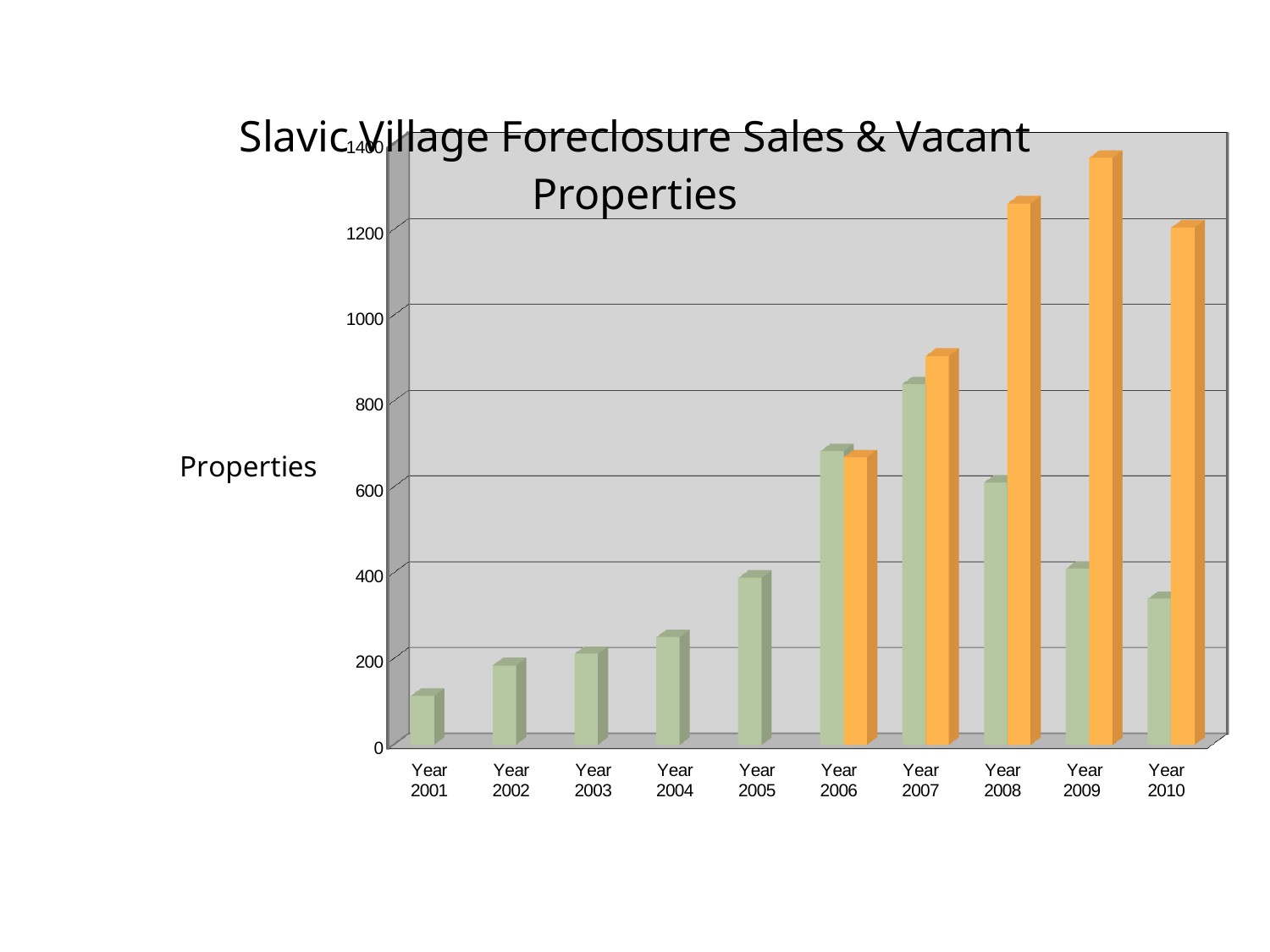
Is the value of the green bar for Year 2001 greater or less than 200? less Do the green bars rise or fall from Year 2001 to Year 2007? Rise In which year is the orange bar the tallest? Year 2009 In how many years does the chart show an orange bar? 5 Is the value of the green bar for Year 2007 greater or less than 800? greater What kind of chart is shown on the slide? Bar chart In which year is the green bar the shortest? Year 2001 What is the title of the chart? Slavic Village Foreclosure Sales & Vacant Properties How many years are shown along the x axis of the chart? 10 In which year is the green bar the tallest? Year 2007 In Year 2008, which is larger, the orange bar or the green bar? The orange bar Is the value of the orange bar for Year 2009 greater or less than 1200? greater